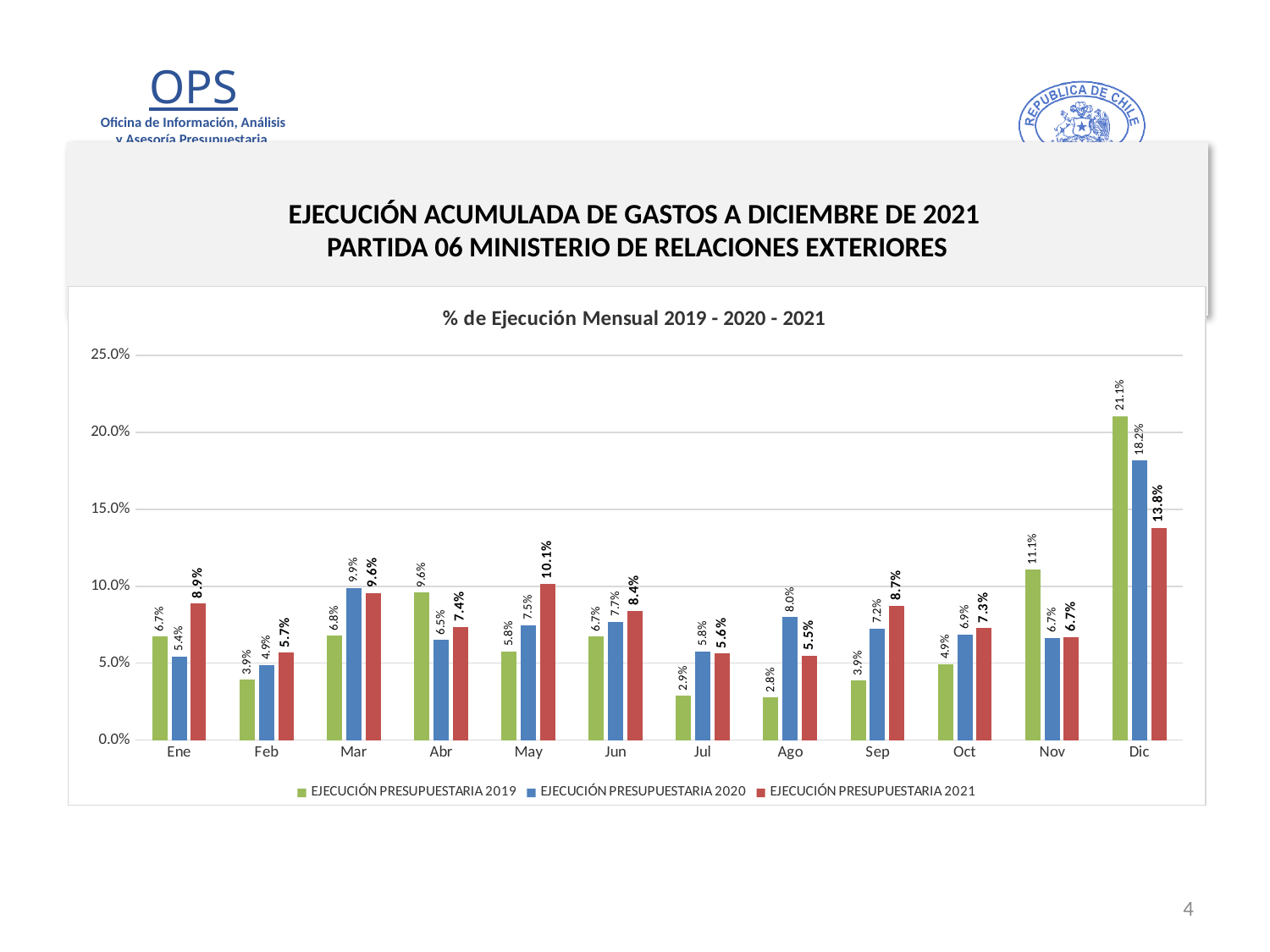
What kind of chart is shown? Bar chart What is the title of the chart? % de Ejecución Mensual 2019 - 2020 - 2021 How many series does the legend list? 3 What is the value for EJECUCIÓN PRESUPUESTARIA 2021 in May? 10.1% Is the value for EJECUCIÓN PRESUPUESTARIA 2020 in Dic greater or less than 15.0%? greater What is the value for EJECUCIÓN PRESUPUESTARIA 2020 in Mar? 9.9% What is the value for EJECUCIÓN PRESUPUESTARIA 2019 in Dic? 21.1% Which month has the lowest value for EJECUCIÓN PRESUPUESTARIA 2019? Ago How many months are shown on the x axis? 12 Which is larger in Ago: the value for EJECUCIÓN PRESUPUESTARIA 2020 or EJECUCIÓN PRESUPUESTARIA 2021? EJECUCIÓN PRESUPUESTARIA 2020 Which month has the highest value for EJECUCIÓN PRESUPUESTARIA 2021? Dic What is the difference between the 2019 and 2021 values in Dic? 7.3%